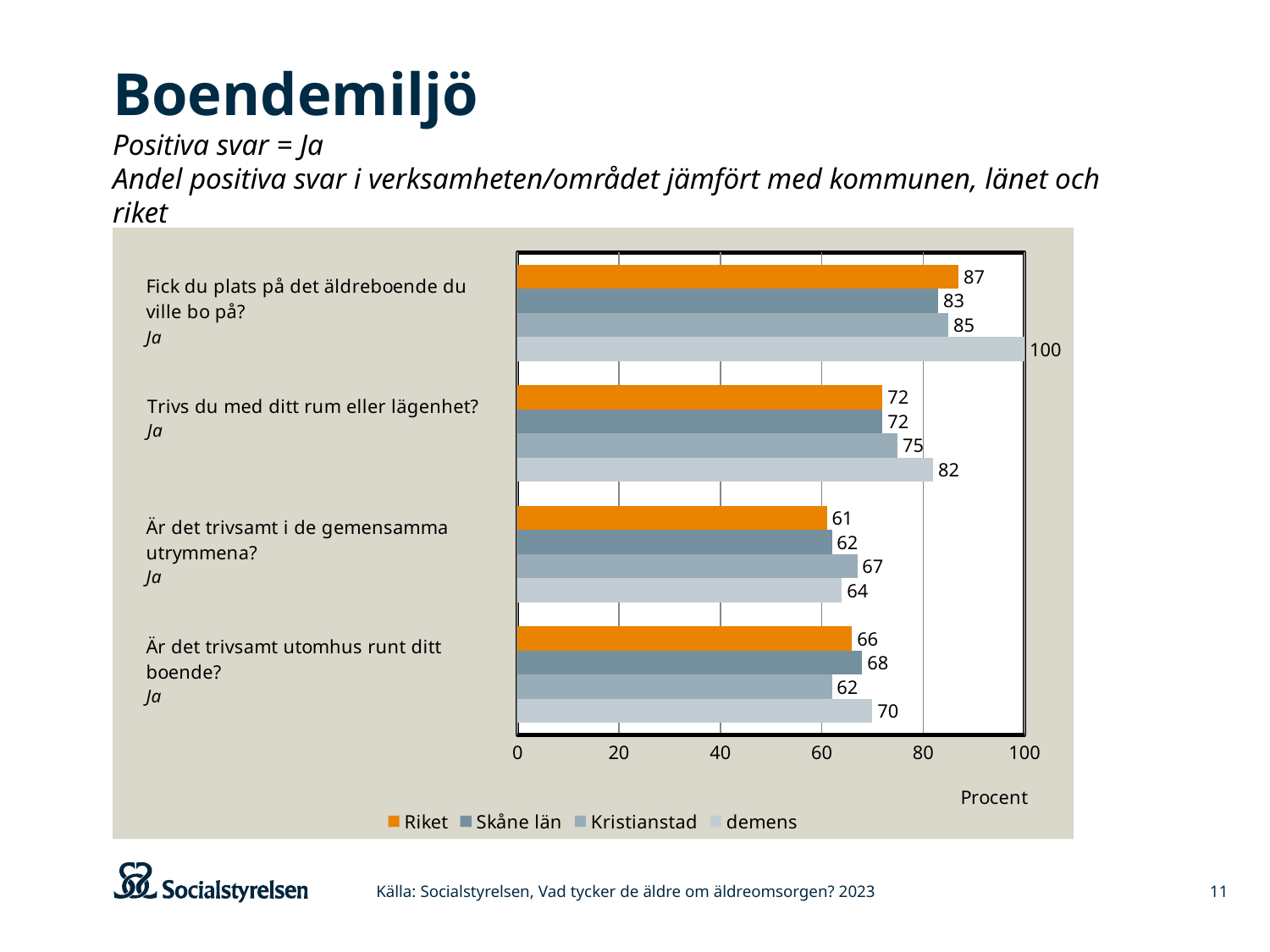
What kind of chart is shown on the slide? Bar chart What is the label of the horizontal axis? Procent What is the difference between the demens value and the Riket value on "Fick du plats på det äldreboende du ville bo på?"? 13 What is the value for Kristianstad on "Är det trivsamt i de gemensamma utrymmena?"? 67 What is the value for demens on "Fick du plats på det äldreboende du ville bo på?"? 100 Which series has the lowest value on "Är det trivsamt utomhus runt ditt boende?"? Kristianstad What is the value for Riket on "Trivs du med ditt rum eller lägenhet?"? 72 On "Är det trivsamt i de gemensamma utrymmena?", which is larger: the Kristianstad value or the demens value? Kristianstad How many question categories are shown in the chart? 4 Which series has the highest value on "Trivs du med ditt rum eller lägenhet?"? demens How many series does the legend list? 4 What is the value for Skåne län on "Är det trivsamt utomhus runt ditt boende?"? 68